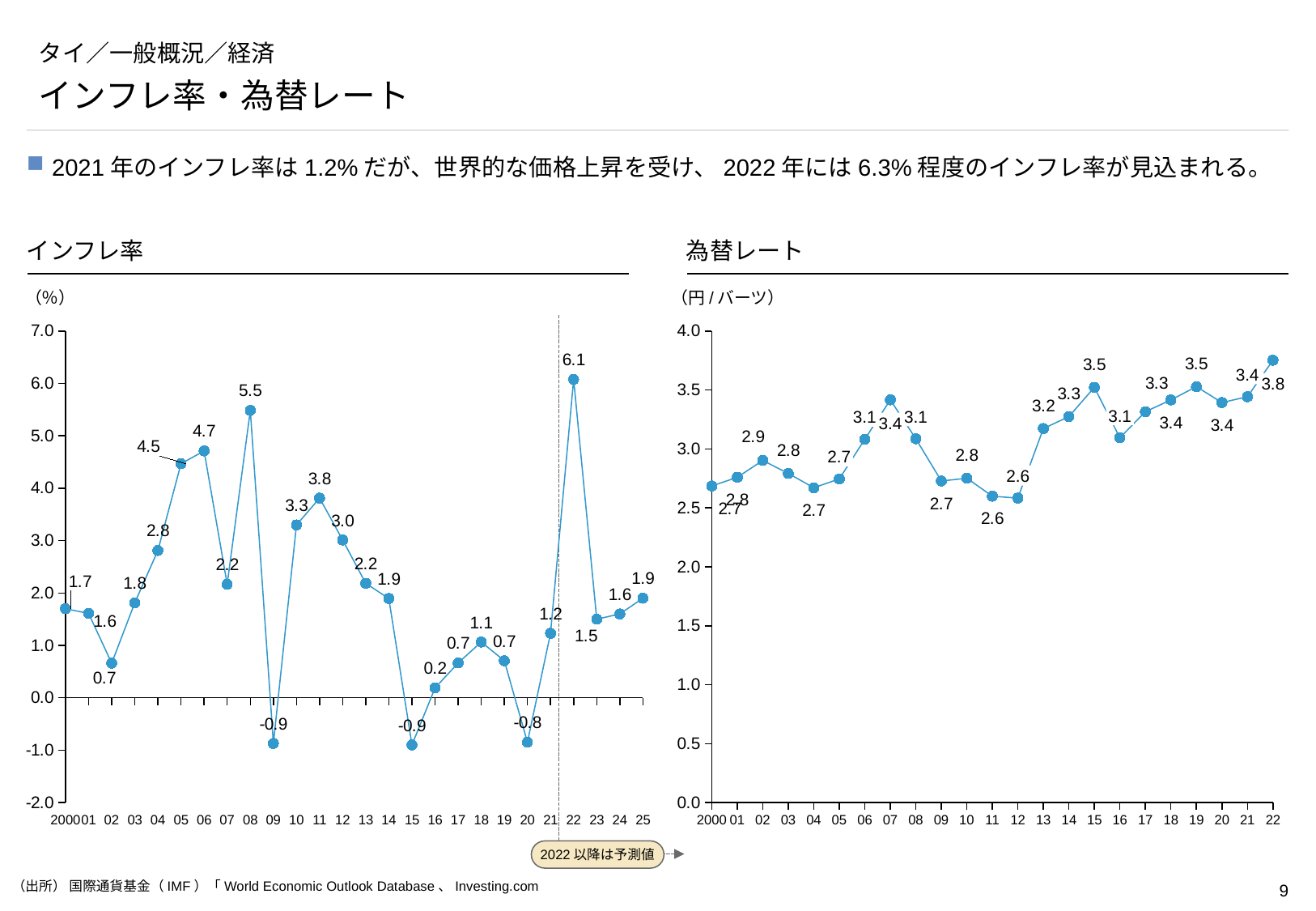
On the インフレ率 chart, what is the difference between the values for 22 and 08? 0.6 On the インフレ率 chart, is the value for 05 greater or less than 4.0? greater On the 為替レート chart, what is the value for 22? 3.8 On the 為替レート chart, what is the value for 07? 3.4 On the 為替レート chart, which year has the highest value? 22 How many data points are plotted on the 為替レート chart? 23 What kind of chart is the インフレ率 chart? line chart On the インフレ率 chart, which is larger, the value for 11 or the value for 12? 11 On the インフレ率 chart, what is the value for 20? -0.8 On the インフレ率 chart, which year has the highest value? 22 On the 為替レート chart, what is the difference between the values for 22 and 2000? 1.1 On the インフレ率 chart, what is the inflation rate value for 08? 5.5